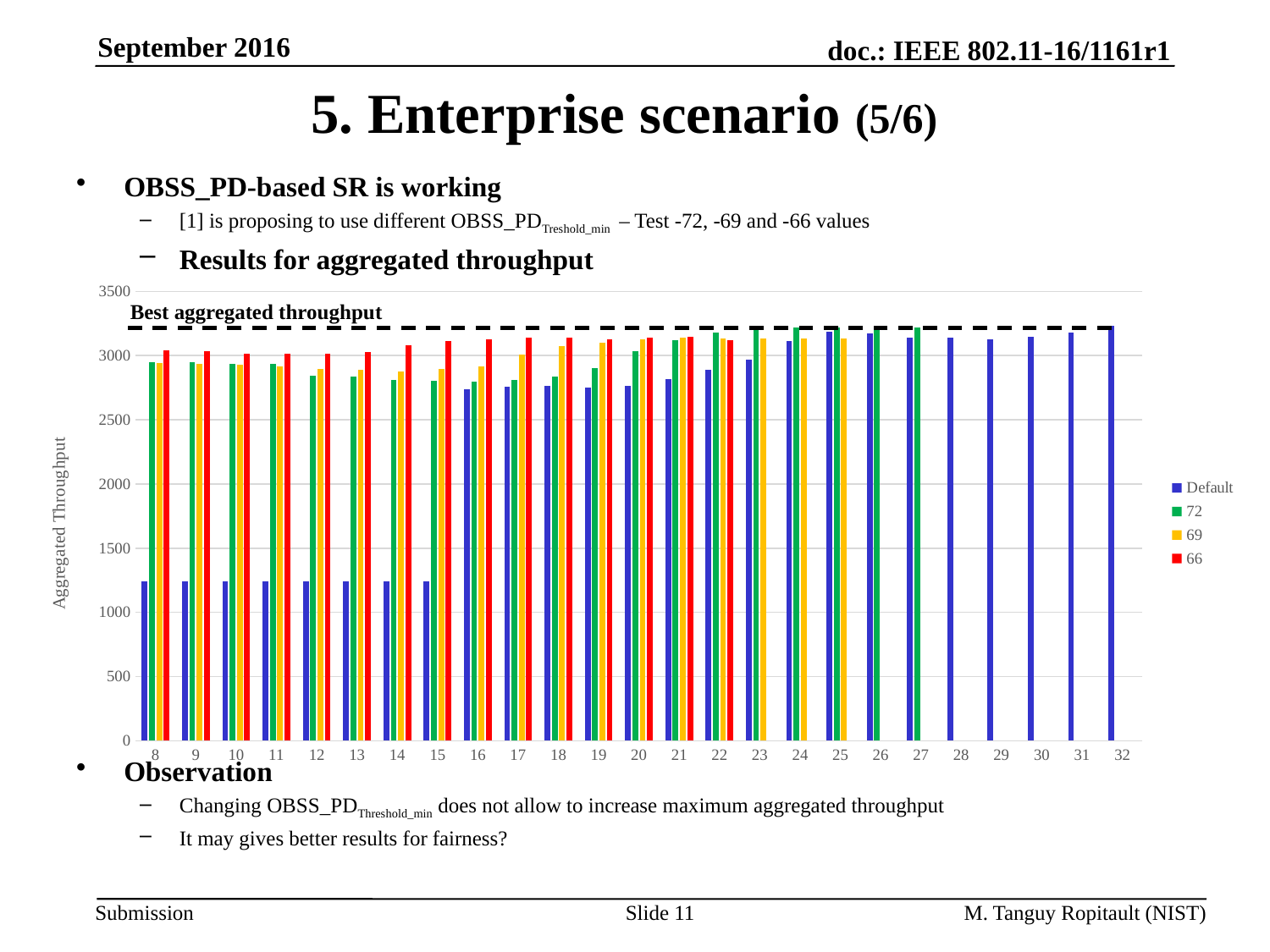
What kind of chart is shown on the slide? bar chart How many series does the chart legend list? 4 What is the label of the y axis of the chart? Aggregated Throughput Is the Default value for category 8 greater or less than 1000? greater Do the Default values generally rise or fall as the x axis goes from 8 to 32? rise For category 8, which is larger: the Default value or the 66 value? 66 What are the series names listed in the chart legend? Default, 72, 69, 66 Is the Default value for category 32 greater or less than 3000? greater Is the Default value for category 8 greater or less than 1500? less How many categories are shown along the x axis of the chart? 25 For category 8, which series has the lowest value? Default